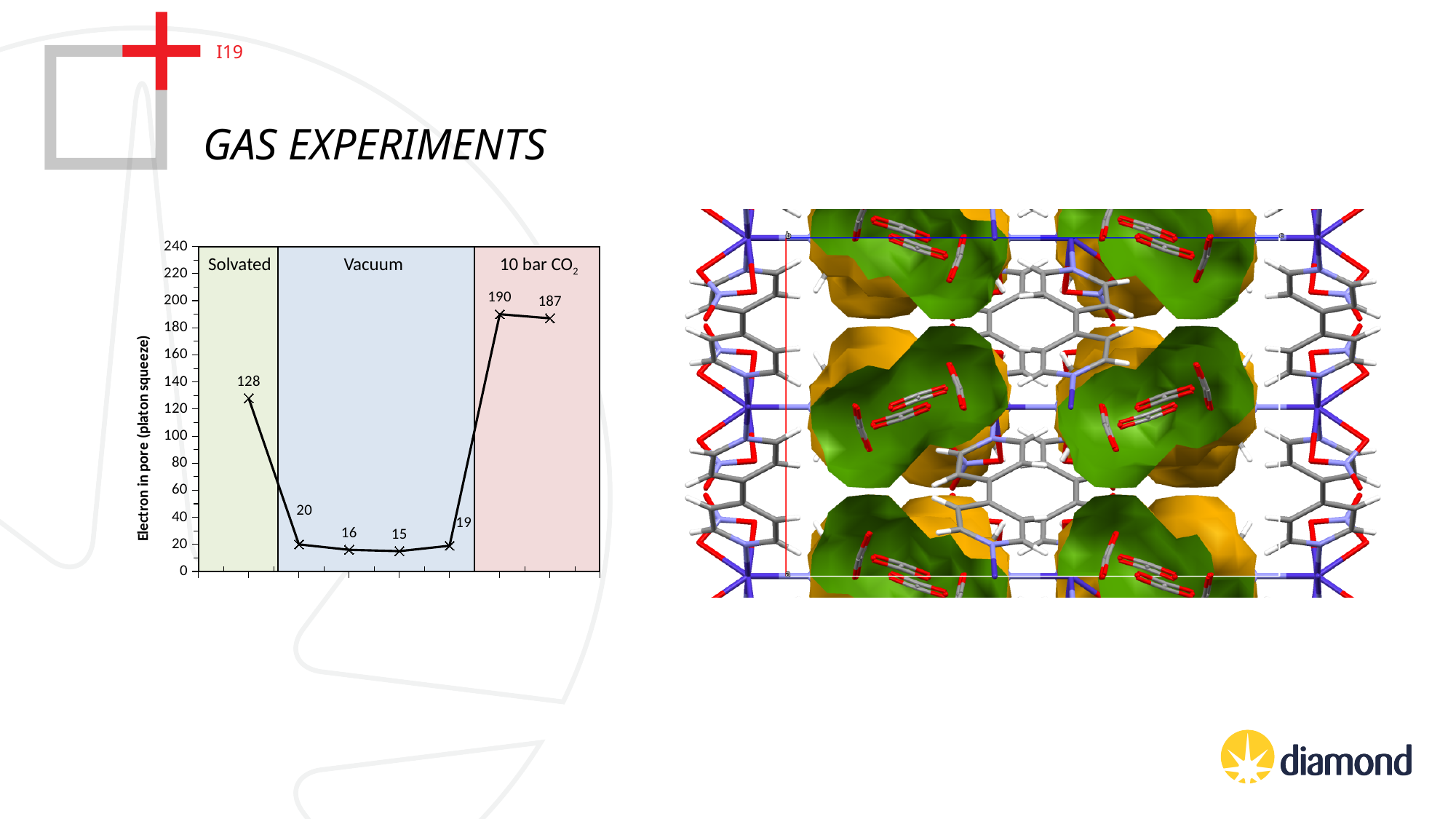
Is the Solvated value greater or less than 100? greater What type of chart is shown on the slide? line chart What is the label of the y axis? Electron in pore (platon squeeze) What is the highest value plotted on the chart? 190 What is the lowest value plotted in the Vacuum region? 15 What is the difference between the first and last points in the Vacuum region (20 and 19)? 1 How do the values change across the Vacuum region from its first point to its last point? they fall from 20 to 15, then rise to 19 What is the value of the last data point in the 10 bar CO2 region? 187 Which is larger: the Solvated value or the first value in the 10 bar CO2 region? the first value in the 10 bar CO2 region What is the difference between the first point in the 10 bar CO2 region (190) and the Solvated point (128)? 62 What is the value of the single data point in the Solvated region? 128 How many data points are plotted on the line chart? 7